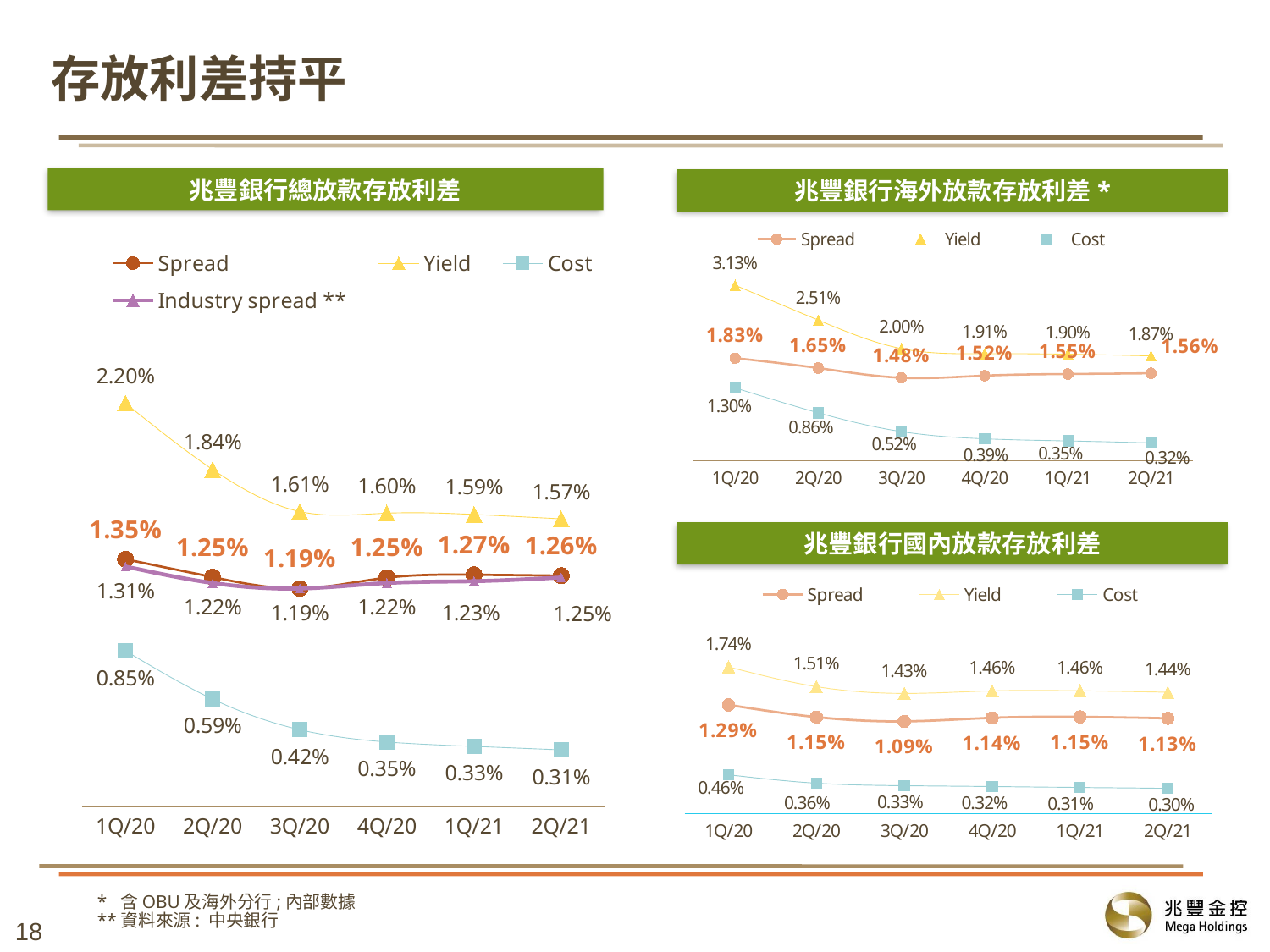
In the 兆豐銀行總放款存放利差 chart, what is the difference between the Yield and Cost values in 1Q/20? 1.35% In the 兆豐銀行總放款存放利差 chart, does the Cost series rise or fall from 1Q/20 to 2Q/21? Fall In the 兆豐銀行國內放款存放利差 chart, what is the Spread value for 3Q/20? 1.09% In the 兆豐銀行海外放款存放利差 chart, what is the Yield value for 1Q/20? 3.13% In the 兆豐銀行海外放款存放利差 chart, what is the difference between the Spread in 1Q/20 and the Spread in 3Q/20? 0.35% What kind of chart is the 兆豐銀行國內放款存放利差 chart? Line chart In the 兆豐銀行總放款存放利差 chart, in which quarter is the Spread lowest? 3Q/20 In the 兆豐銀行總放款存放利差 chart, what is the Industry spread value for 2Q/21? 1.25% In the 兆豐銀行總放款存放利差 chart, how many series does the legend list? 4 In the 兆豐銀行總放款存放利差 chart, what is the Spread value for 1Q/20? 1.35% In the 兆豐銀行國內放款存放利差 chart, which is larger, the Yield in 2Q/20 or the Yield in 2Q/21? 2Q/20 In the 兆豐銀行海外放款存放利差 chart, what is the Cost value for 2Q/21? 0.32%